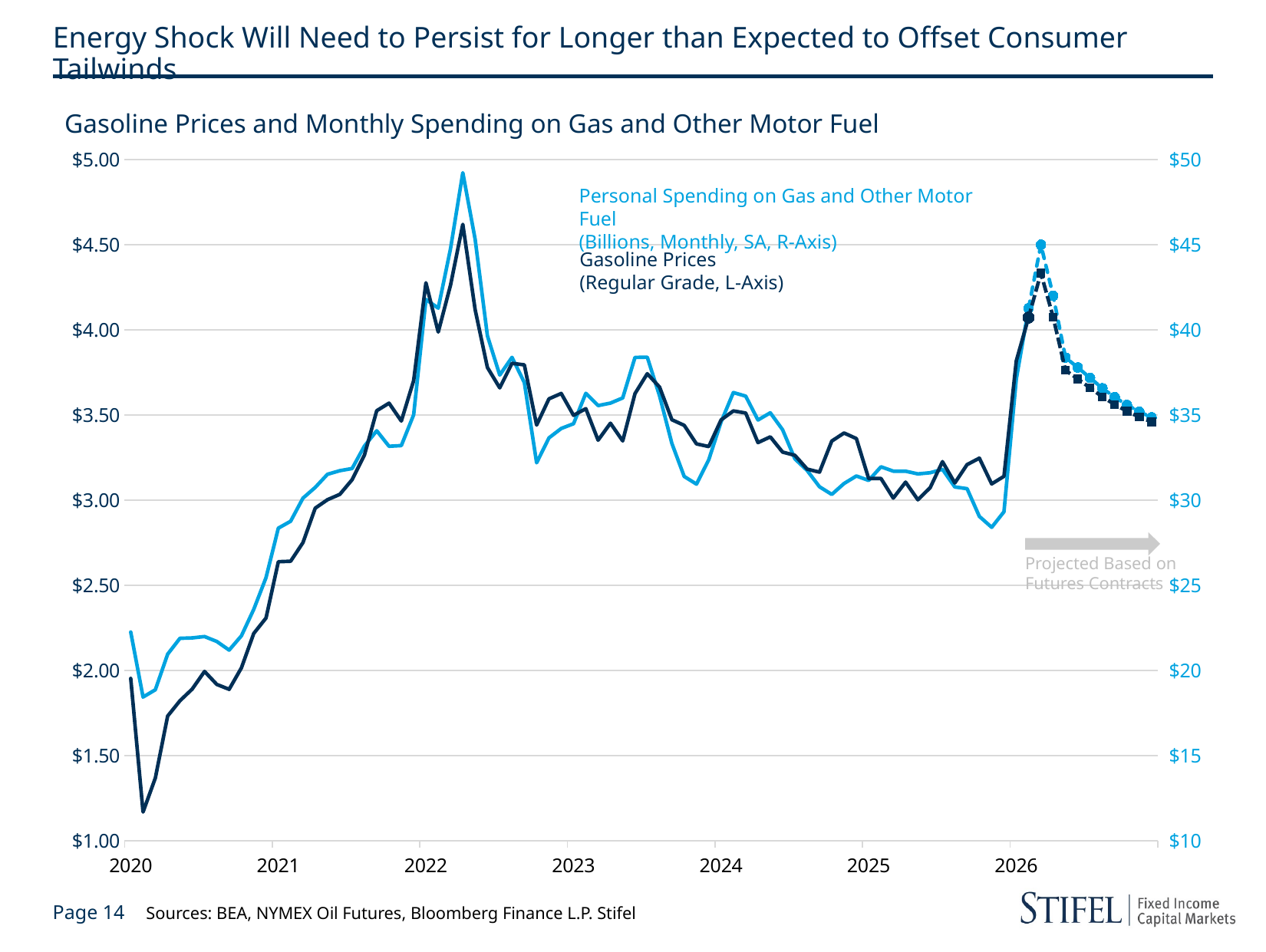
Do Gasoline Prices rise or fall from the start of 2020 to the peak in 2022? rise How many series does the chart plot? 4 What is the title of the chart? Gasoline Prices and Monthly Spending on Gas and Other Motor Fuel How many years are labeled on the x axis? 7 Is the lowest Personal Spending on Gas and Other Motor Fuel value in 2020 greater or less than $20? less Is the peak Gasoline Prices value in 2022 greater or less than $4.00? greater What kind of chart is shown on the slide? line chart Is the peak Personal Spending on Gas and Other Motor Fuel value in 2022 greater or less than $45? greater Which axis is the Gasoline Prices series plotted against? L-Axis (left axis)